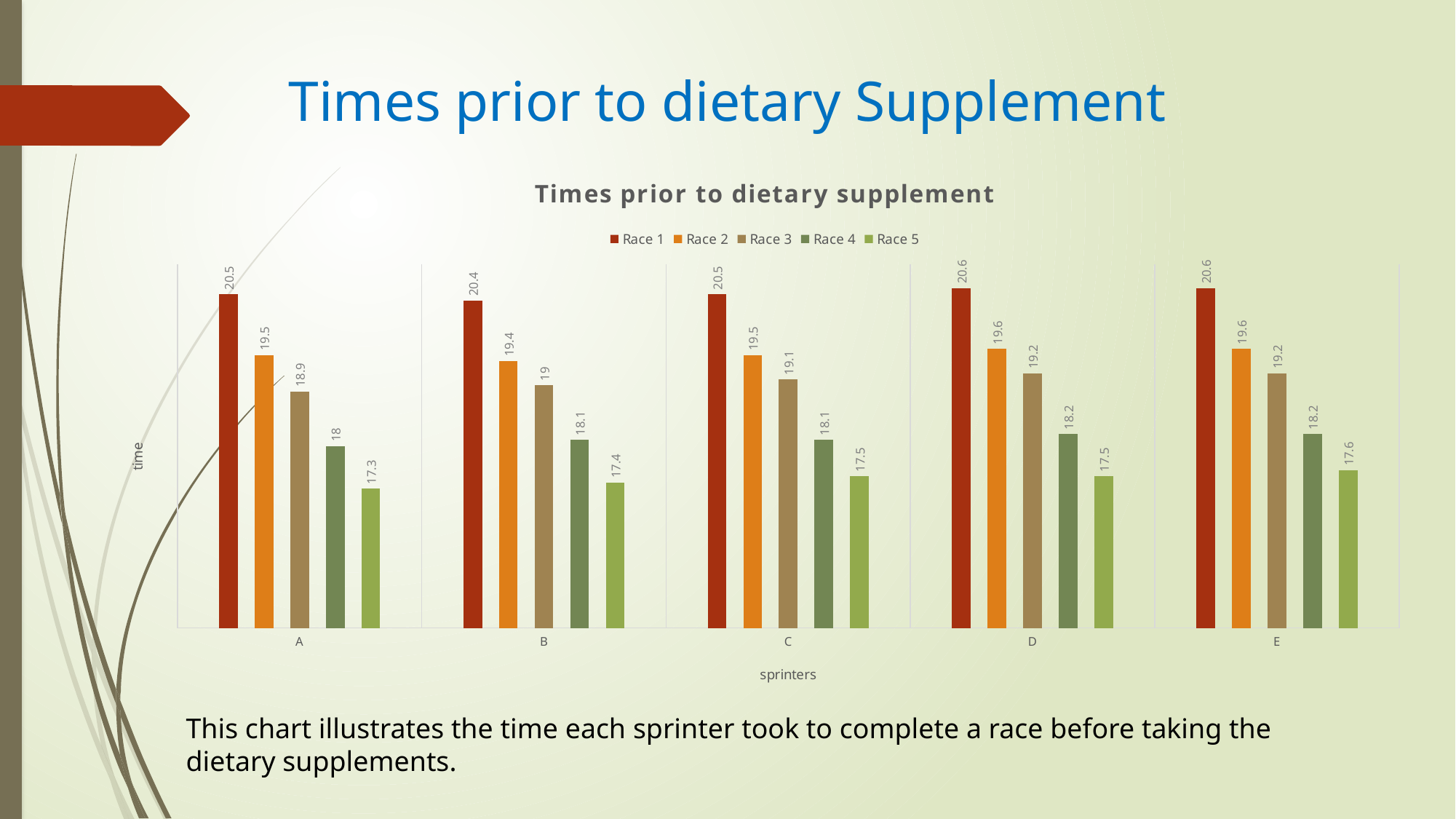
How many sprinters are shown on the x axis? 5 What kind of chart is shown on the slide? Bar chart What is the difference between the Race 2 times for sprinter D and sprinter A? 0.1 What is the Race 3 time for sprinter B? 19 How many series does the legend list? 5 What is the Race 4 time for sprinter D? 18.2 Which race has the highest time for sprinter B? Race 1 What is the Race 1 time for sprinter A? 20.5 Which race has the lowest time for sprinter C? Race 5 Which is larger, the Race 3 time for sprinter A or the Race 3 time for sprinter E? Sprinter E What is the Race 5 time for sprinter E? 17.6 What is the difference between the Race 1 and Race 5 times for sprinter A? 3.2